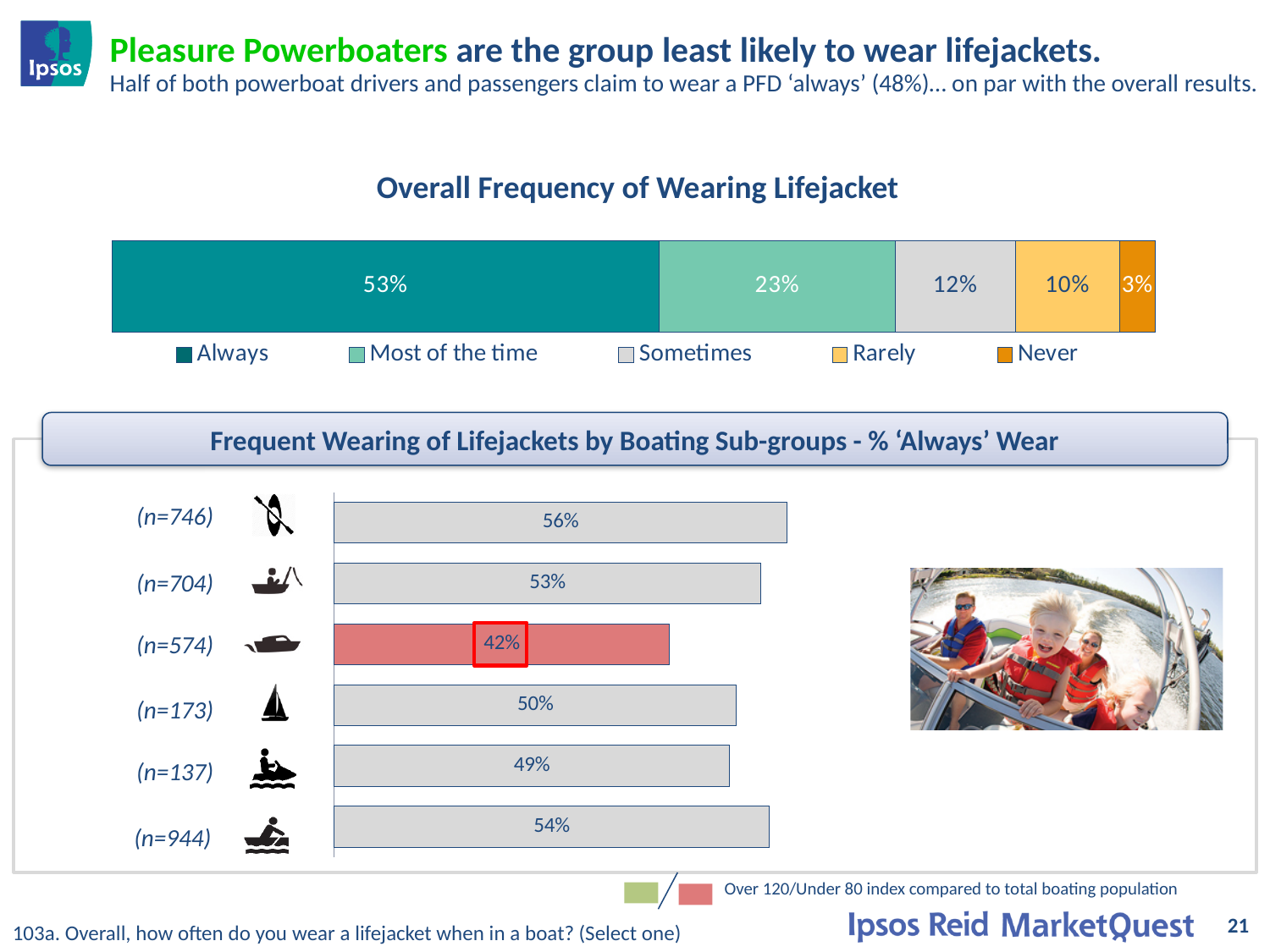
In the 'Frequent Wearing of Lifejackets by Boating Sub-groups' chart, what is the value for the group with n=944? 54% In the 'Frequent Wearing of Lifejackets by Boating Sub-groups' chart, what is the difference between the highest value (56%) and the lowest value (42%)? 14% In the 'Overall Frequency of Wearing Lifejacket' chart, how many response categories does the legend list? 5 In the 'Frequent Wearing of Lifejackets by Boating Sub-groups' chart, what is the '% Always wear' value for the group with n=574? 42% In the 'Frequent Wearing of Lifejackets by Boating Sub-groups' chart, which bar is coloured red instead of grey? The 42% bar (n=574) In the 'Frequent Wearing of Lifejackets by Boating Sub-groups' chart, how many sub-groups (bars) are shown? 6 What kind of chart is the 'Overall Frequency of Wearing Lifejacket' chart? Stacked bar chart In the 'Overall Frequency of Wearing Lifejacket' chart, what percentage say 'Rarely'? 10% In the 'Overall Frequency of Wearing Lifejacket' chart, what percentage of respondents say they 'Always' wear a lifejacket? 53% In the 'Overall Frequency of Wearing Lifejacket' chart, which response category has the smallest share? Never In the 'Frequent Wearing of Lifejackets by Boating Sub-groups' chart, which group has the highest '% Always wear' value? The group with n=746 (56%) In the 'Overall Frequency of Wearing Lifejacket' chart, what is the difference between the 'Most of the time' and 'Sometimes' shares? 11%